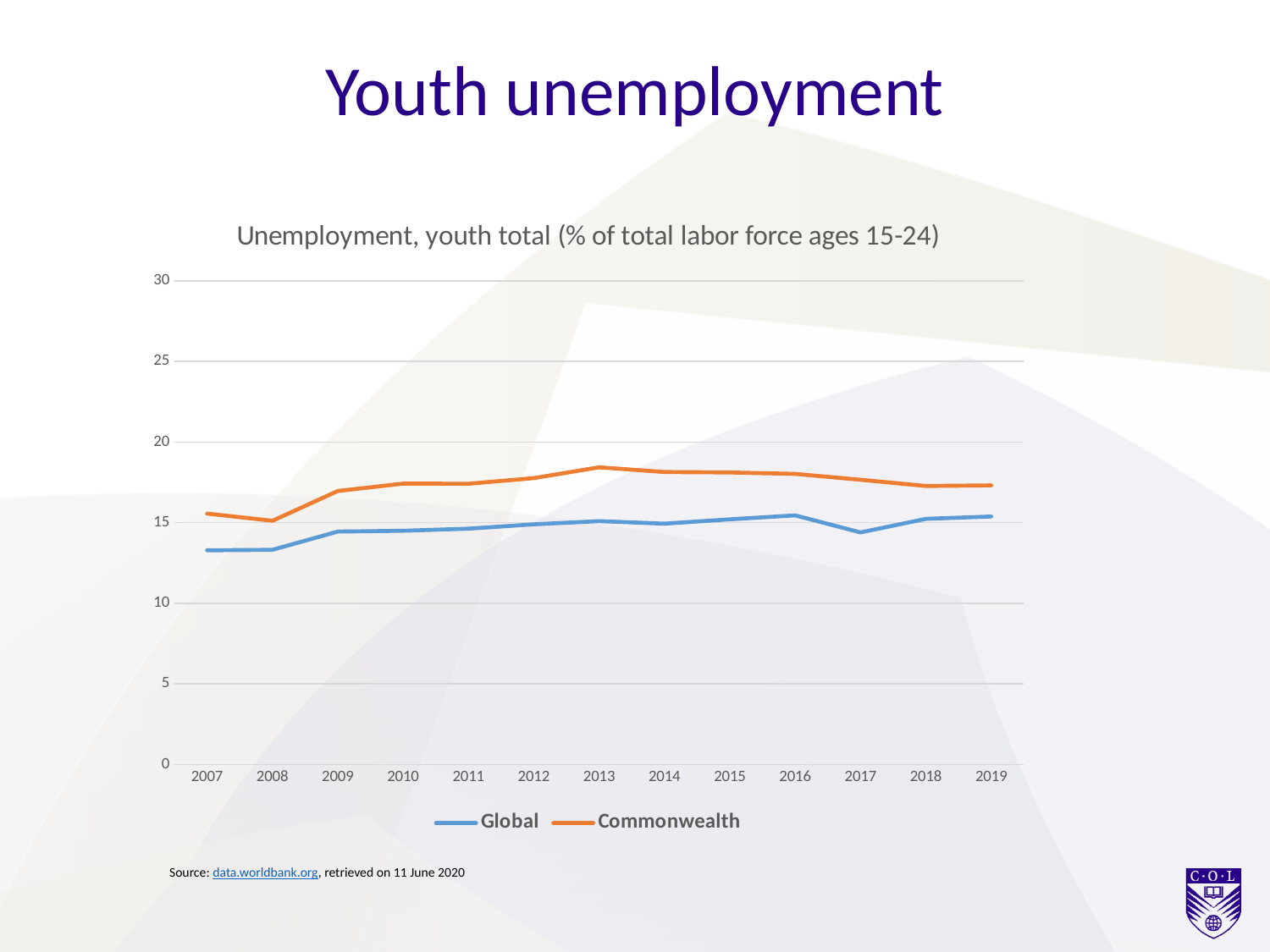
What kind of chart is shown on the slide? line chart How many series does the legend list? 2 Is the Global value for 2017 greater or less than 15? less How many years are plotted along the x axis? 13 Which series is drawn in orange? Commonwealth Is the Commonwealth value for 2013 greater or less than 20? less In which year is the Commonwealth series at its highest? 2013 Is the Global value for 2007 greater or less than 15? less In which year is the Commonwealth series at its lowest? 2008 In 2013, which series has the higher value, Global or Commonwealth? Commonwealth Does the Commonwealth series rise or fall from 2013 to 2019? fall What is the title of the chart? Unemployment, youth total (% of total labor force ages 15-24)